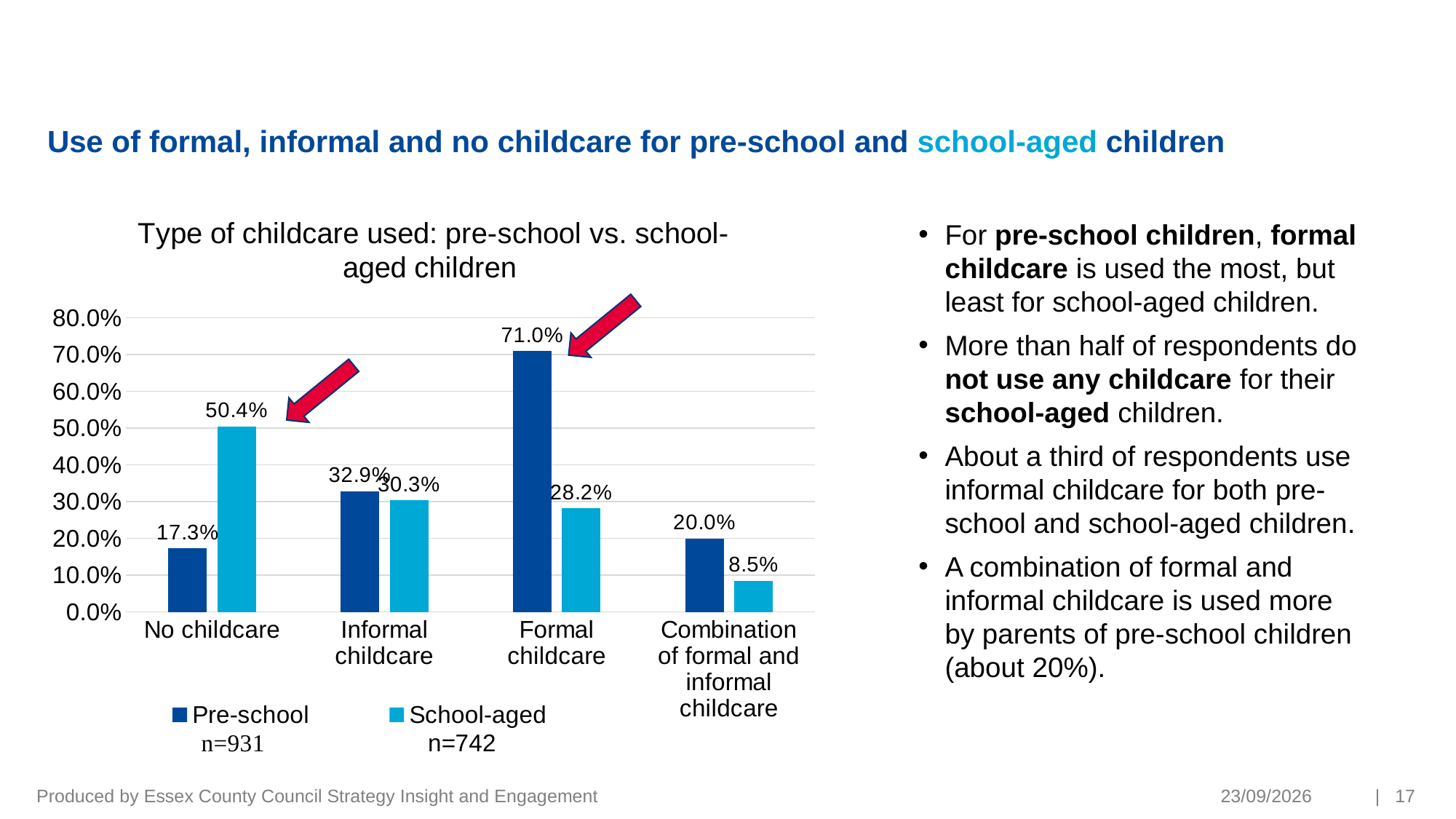
How many series does the legend list? 2 What is the Pre-school value for Informal childcare? 32.9% What is the title of the chart? Type of childcare used: pre-school vs. school-aged children What kind of chart is shown on the slide? Bar chart What is the School-aged value for Combination of formal and informal childcare? 8.5% What is the School-aged value for No childcare? 50.4% What is the difference between the Pre-school and School-aged values for Formal childcare? 42.8% What is the Pre-school value for Formal childcare? 71.0% For No childcare, which series has the larger value, Pre-school or School-aged? School-aged Which category has the highest Pre-school value? Formal childcare How many categories are shown on the x axis? 4 Which category has the lowest School-aged value? Combination of formal and informal childcare